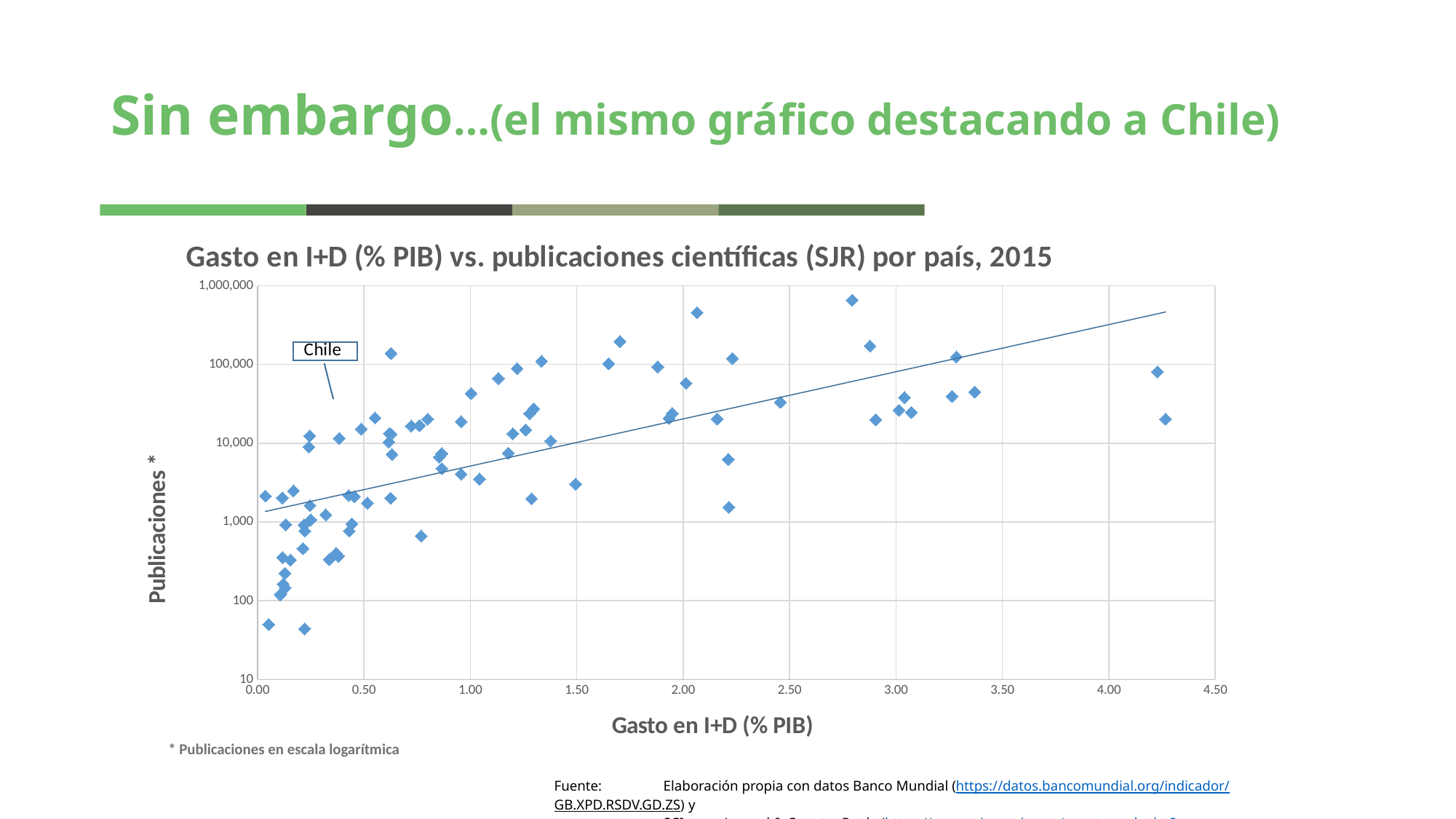
Which country is labelled on the chart? Chile Is the number of publications for the highest point on the chart greater or less than 100,000? greater According to the trend line, do publications rise or fall as R&D spending (% PIB) increases? Rise What is the title of the chart? Gasto en I+D (% PIB) vs. publicaciones científicas (SJR) por país, 2015 Is the number of publications for Chile greater or less than 100,000? less What kind of chart is shown on the slide? Scatter plot What is the highest value shown on the x axis? 4.50 Is the number of publications for Chile greater or less than 1,000? greater What is the highest value shown on the y axis? 1,000,000 What year does the chart's data refer to? 2015